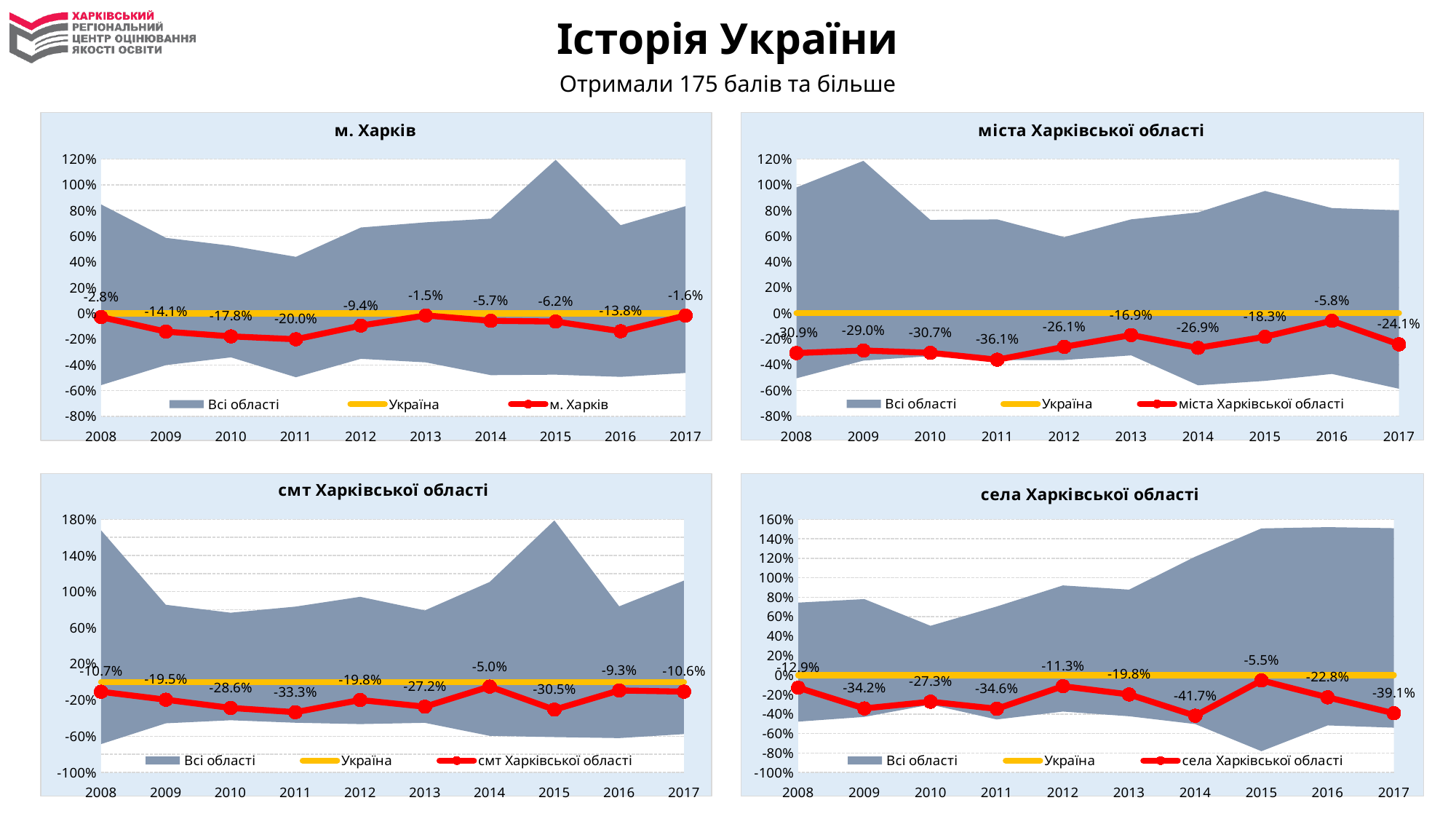
In the chart titled "м. Харків", which year has the highest value on the red м. Харків line? 2013 In the chart titled "смт Харківської області", what is the difference between the red line values for 2011 and 2014? 28.3 percentage points How many series does the legend of the chart titled "смт Харківської області" list? 3 In the chart titled "села Харківської області", what is the value of the red line for 2009? -34.2% In the chart titled "села Харківської області", is the red line value for 2015 larger or smaller than the value for 2017? larger In the chart titled "смт Харківської області", what is the value of the red line for 2014? -5.0% In the chart titled "міста Харківської області", what colour is the Україна line? Yellow In the chart titled "міста Харківської області", what is the value of the red line for 2016? -5.8% In the chart titled "села Харківської області", which year has the lowest value on the red line? 2014 In the chart titled "м. Харків", what is the value of the red м. Харків line for 2011? -20.0% How many years are shown on the x axis of the chart titled "м. Харків"? 10 In the chart titled "міста Харківської області", which year has the lowest value on the red line? 2011